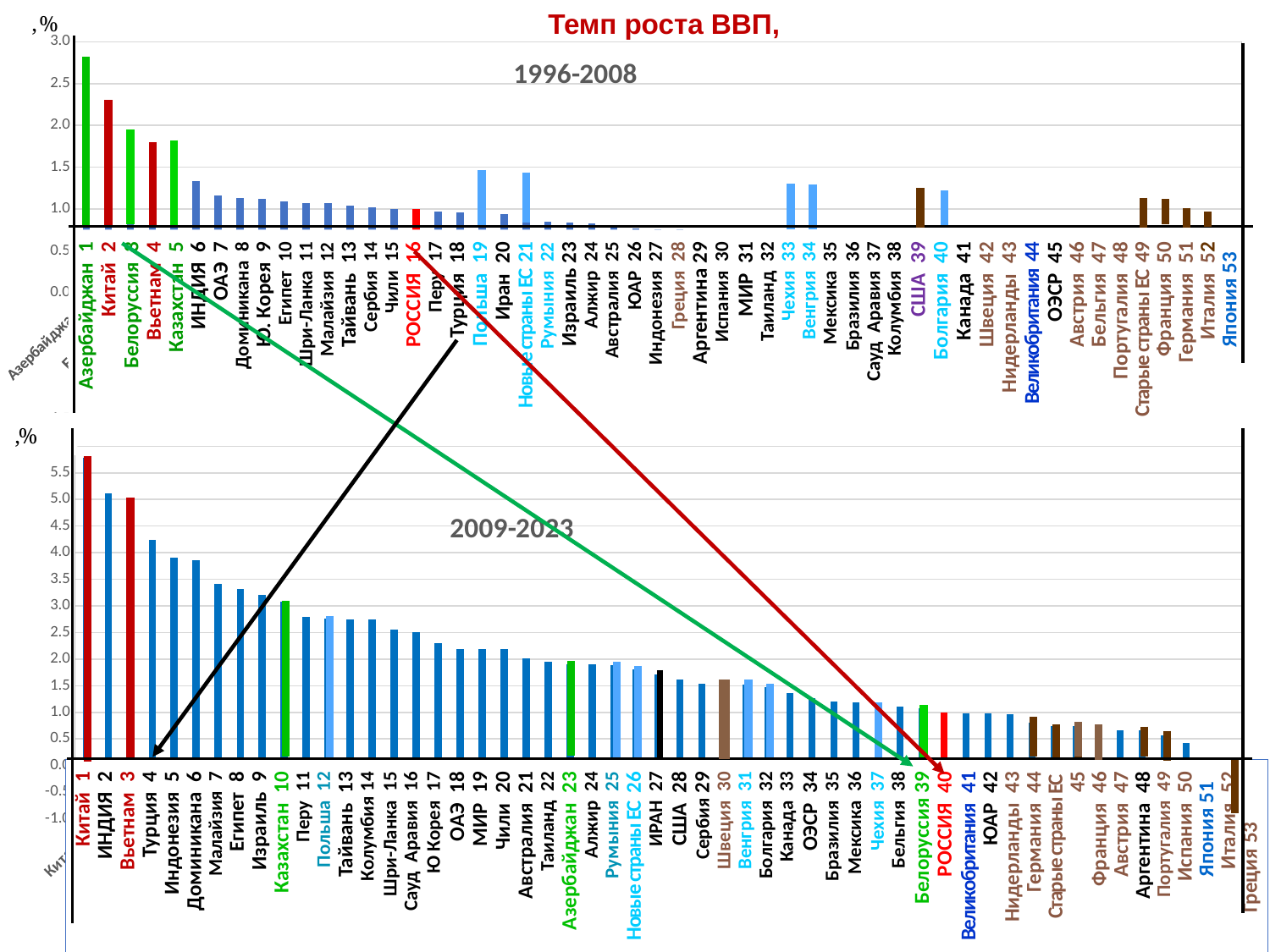
How many countries/categories are shown in the bottom chart (2009-2023)? 53 In the top chart (1996-2008), which country has the highest GDP growth rate? Азербайджан What kind of chart is the top chart (1996-2008)? bar chart In the top chart (1996-2008), which is larger, the value for Азербайджан or the value for Китай? Азербайджан In the bottom chart (2009-2023), is the value for Турция greater or less than 4.0? greater In the bottom chart (2009-2023), is the value for Греция greater or less than 0.0? less In the bottom chart (2009-2023), which country has the lowest GDP growth rate? Греция In the bottom chart (2009-2023), do the values rise or fall from left to right along the x axis? fall In the top chart (1996-2008), which country has the lowest GDP growth rate? Япония In the top chart (1996-2008), is the value for Азербайджан greater or less than 2.5? greater In the bottom chart (2009-2023), which country has the highest GDP growth rate? Китай In the bottom chart (2009-2023), which is larger, the value for Китай or the value for Турция? Китай